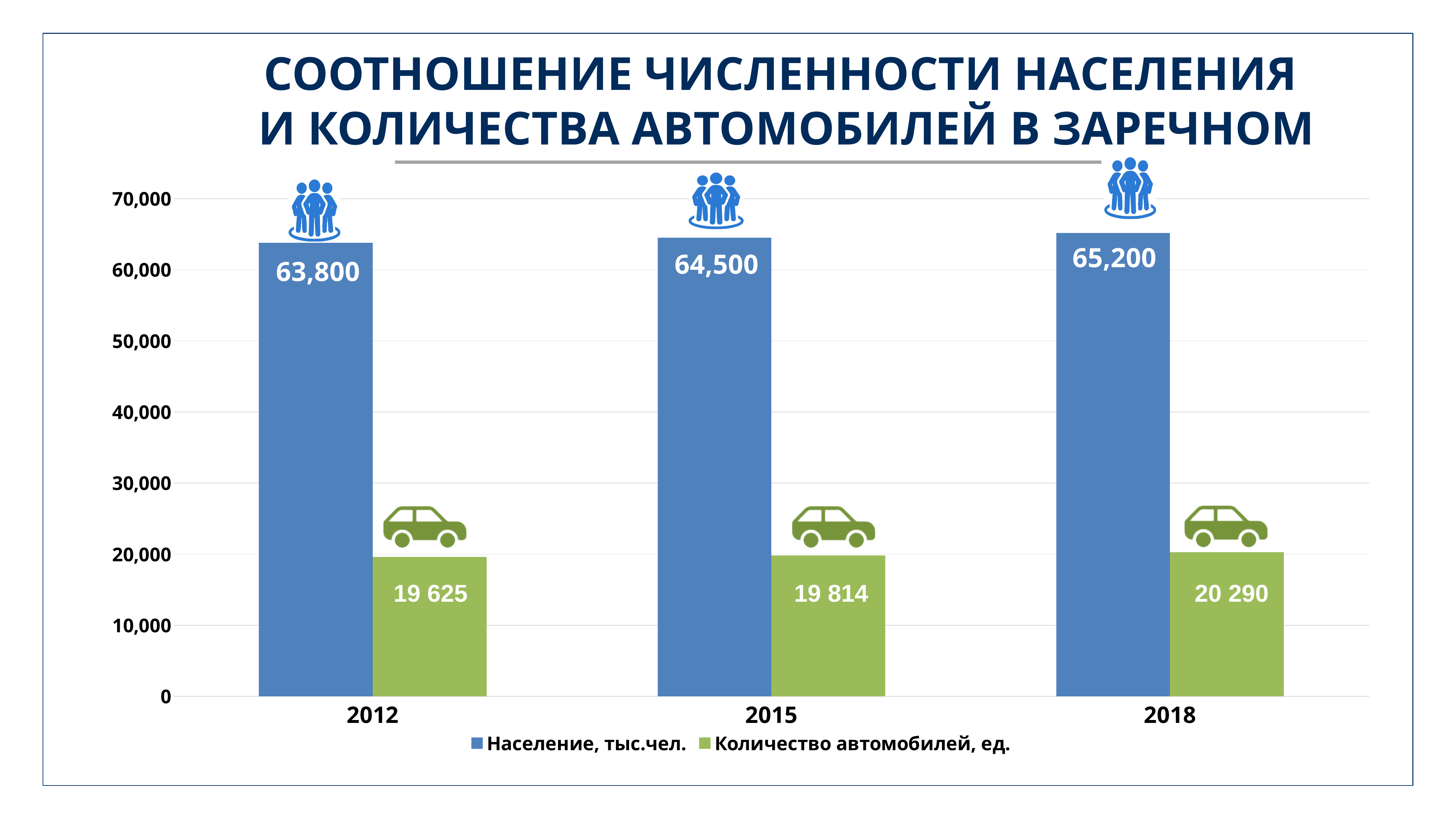
What is the value of Население, тыс.чел. for 2012? 63,800 Which is larger: Население, тыс.чел. in 2015 or Количество автомобилей, ед. in 2015? Население, тыс.чел. How many years are shown on the x axis? 3 What is the value of Количество автомобилей, ед. for 2018? 20 290 Is the value of Население, тыс.чел. for 2015 greater or less than 60,000? greater What kind of chart is shown on the slide? Bar chart What is the difference between Население, тыс.чел. in 2018 and in 2012? 1,400 In which year is Население, тыс.чел. highest? 2018 What is the value of Количество автомобилей, ед. for 2015? 19 814 In which year is Количество автомобилей, ед. lowest? 2012 How many series does the legend list? 2 What is the difference between Количество автомобилей, ед. in 2018 and in 2015? 476